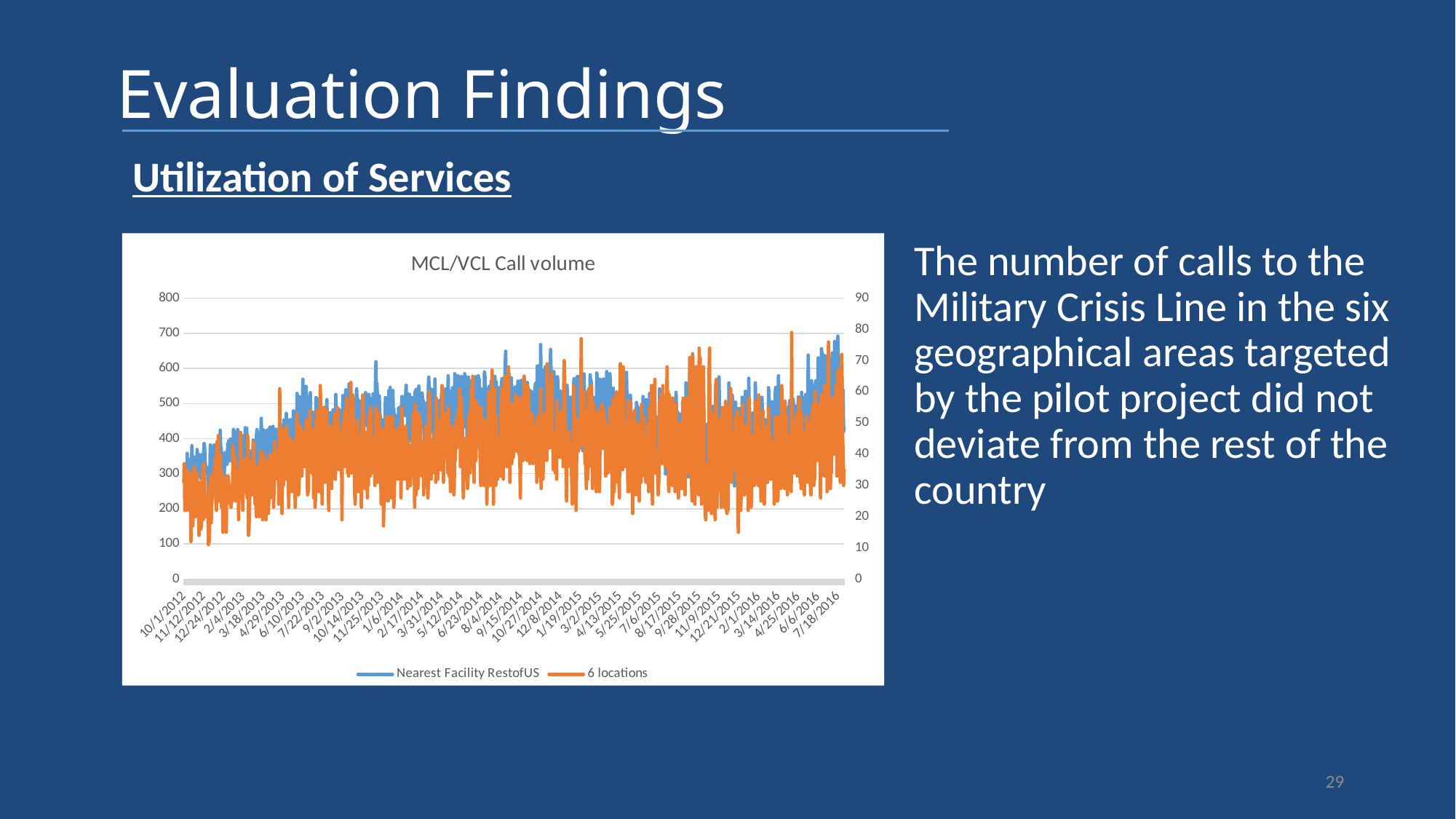
Does the Nearest Facility RestofUS series generally rise or fall from 10/1/2012 to 7/18/2016? Rise What is the maximum value shown on the right vertical axis? 90 What kind of chart is shown on the slide? Line chart What is the maximum value shown on the left vertical axis? 800 What is the title of the chart? MCL/VCL Call volume How many series does the chart's legend list? 2